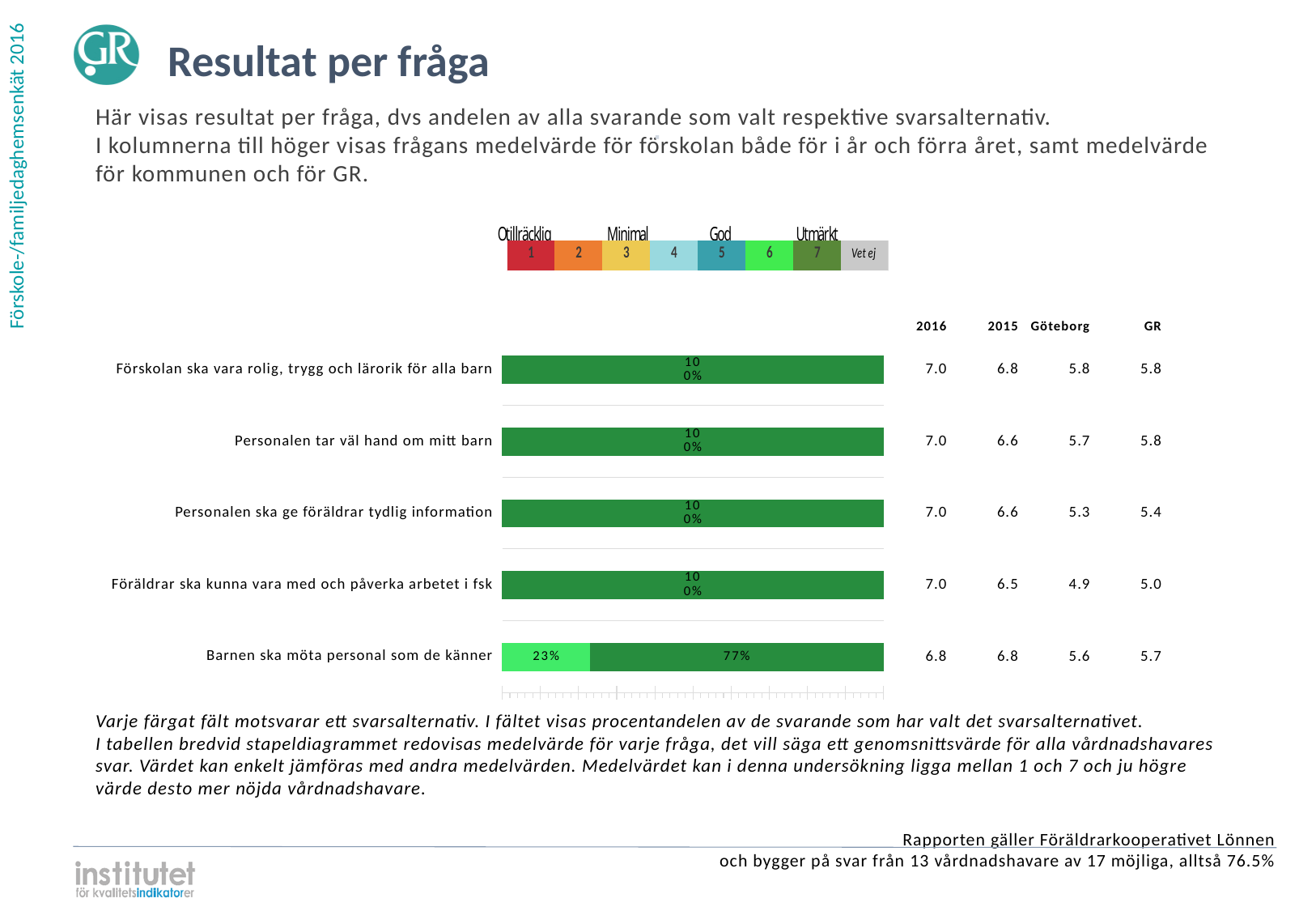
What is the 2016 mean value shown for "Barnen ska möta personal som de känner"? 6.8 What percentage is shown on the bar for "Förskolan ska vara rolig, trygg och lärorik för alla barn"? 100% What is the total of the two segments in the bar for "Barnen ska möta personal som de känner"? 100% How many answer alternatives, including "Vet ej", does the legend show? 8 What percentage of respondents chose answer 6 for "Barnen ska möta personal som de känner"? 23% For "Barnen ska möta personal som de känner", what is the difference between the share choosing 7 and the share choosing 6? 54 percentage points What label does the legend give to answer alternative 7? Utmärkt How many questions (categories) are plotted as bars in the chart? 5 Which question has the lowest 2016 mean value in the table next to the chart? Barnen ska möta personal som de känner What kind of chart is shown on the slide? Bar chart What percentage of respondents chose answer 7 (Utmärkt) for "Barnen ska möta personal som de känner"? 77% For "Barnen ska möta personal som de känner", which answer alternative has the larger share, 6 or 7? 7